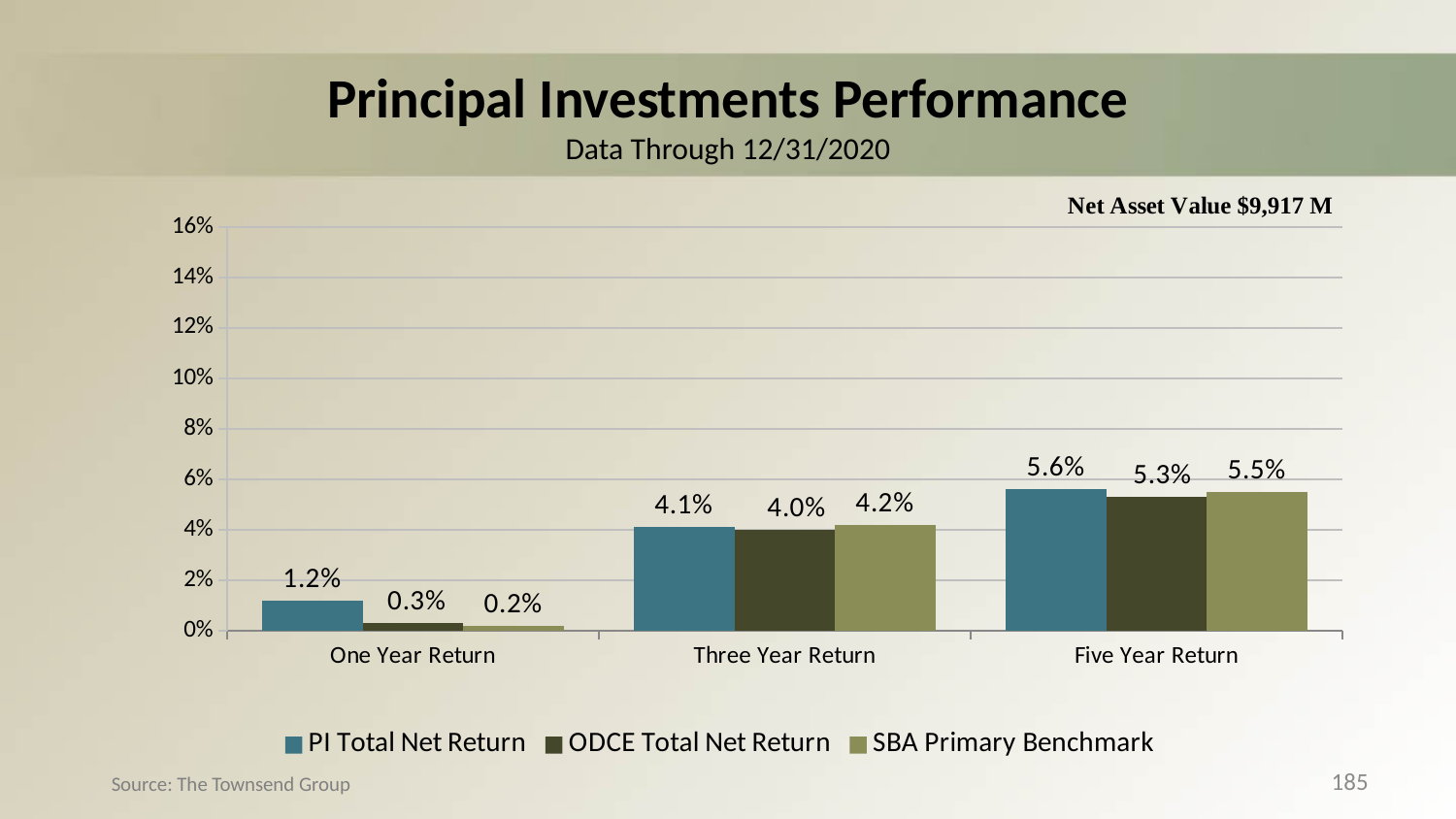
What is the PI Total Net Return for the One Year Return period? 1.2% For the Three Year Return period, which is larger: the PI Total Net Return or the SBA Primary Benchmark? SBA Primary Benchmark What is the SBA Primary Benchmark value for the Five Year Return period? 5.5% What is the ODCE Total Net Return for the Three Year Return period? 4.0% Is the PI Total Net Return for the Five Year Return period greater or less than 4%? greater Which period has the highest PI Total Net Return? Five Year Return How many return periods are shown on the x axis? 3 How many series does the legend list? 3 What kind of chart is shown on the slide? Bar chart What Net Asset Value is stated on the chart? $9,917 M What is the difference between the PI Total Net Return and the ODCE Total Net Return for the One Year Return period? 0.9% Which period has the lowest SBA Primary Benchmark value? One Year Return